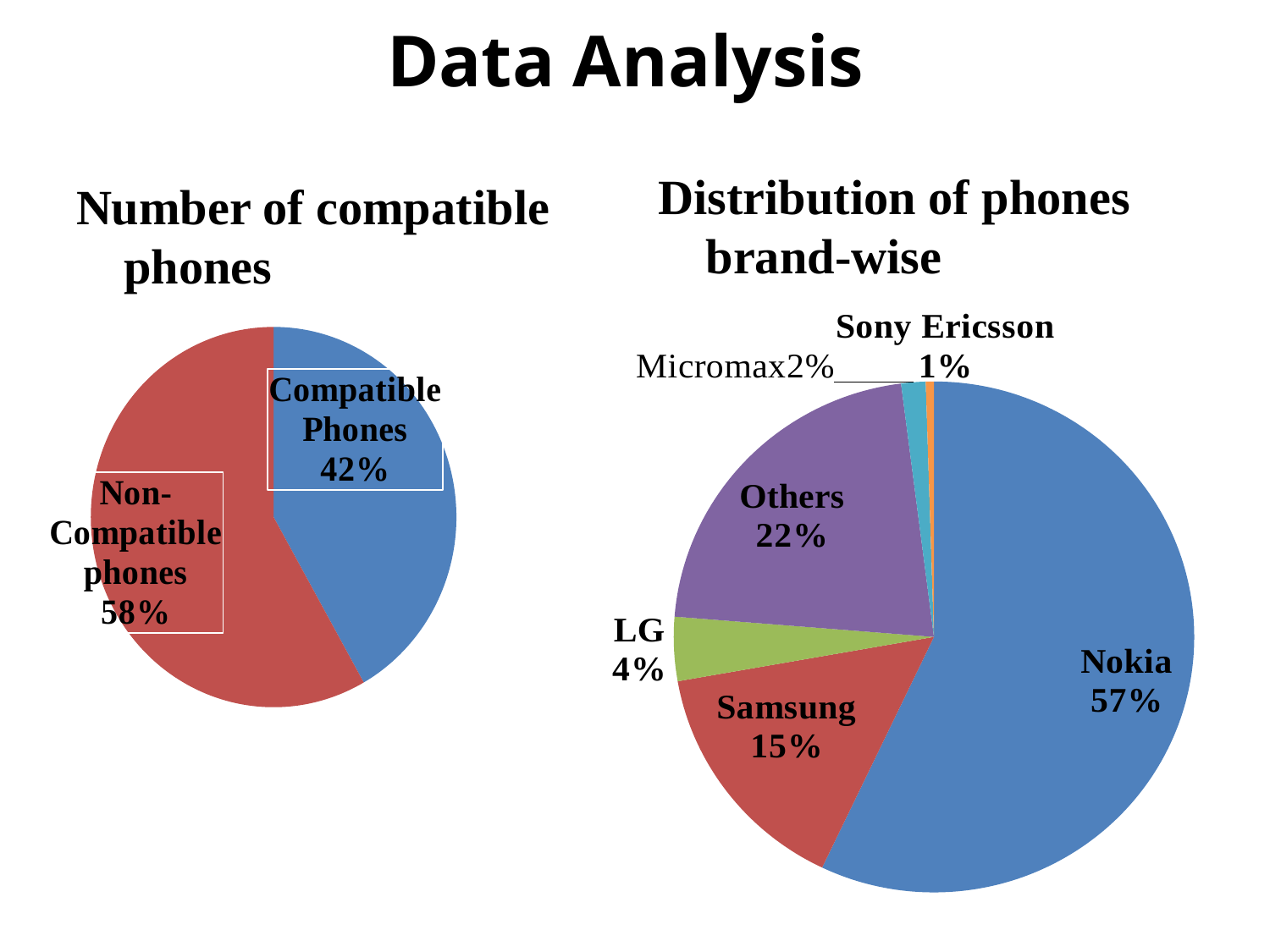
In the 'Distribution of phones brand-wise' chart, what share does Others have? 22% In the 'Number of compatible phones' chart, what is the difference between the Non-Compatible and Compatible shares? 16% In the 'Distribution of phones brand-wise' chart, what share does Nokia have? 57% In the 'Distribution of phones brand-wise' chart, which brand has the largest share? Nokia In the 'Number of compatible phones' chart, what share of phones are Compatible Phones? 42% In the 'Distribution of phones brand-wise' chart, what is the difference between the Others and Samsung shares? 7% In the 'Distribution of phones brand-wise' chart, which brand has the smallest share? Sony Ericsson What kind of chart is the 'Number of compatible phones' chart? Pie chart In the 'Number of compatible phones' chart, which slice is larger, Compatible Phones or Non-Compatible phones? Non-Compatible phones In the 'Distribution of phones brand-wise' chart, how many slices are there? 6